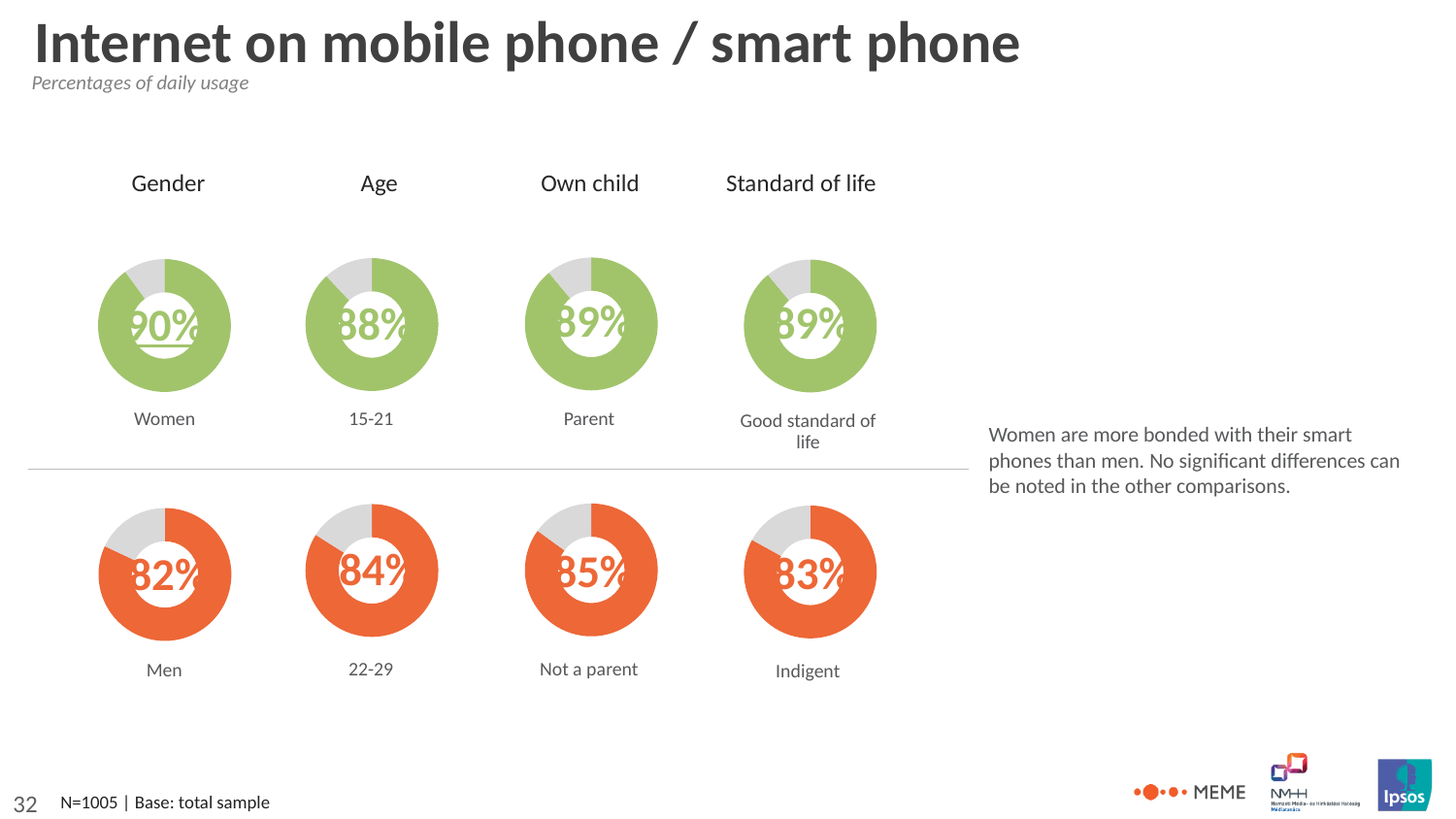
What is the value shown in the donut chart labelled Men? 82% What is the value shown in the donut chart labelled Indigent? 83% What is the difference between the Women donut chart value and the Men donut chart value? 8% What is the difference between the 15-21 donut chart value and the 22-29 donut chart value? 4% How many donut charts are shown on the slide? 8 Across all the donut charts on the slide, which category has the lowest value? Men What is the value shown in the donut chart labelled Not a parent? 85% Which has the larger value, the Parent donut chart or the Not a parent donut chart? Parent What is the value shown in the donut chart labelled Women? 90% What colour are the donut charts in the bottom row? Orange Across all the donut charts on the slide, which category has the highest value? Women What is the value shown in the donut chart labelled 22-29? 84%